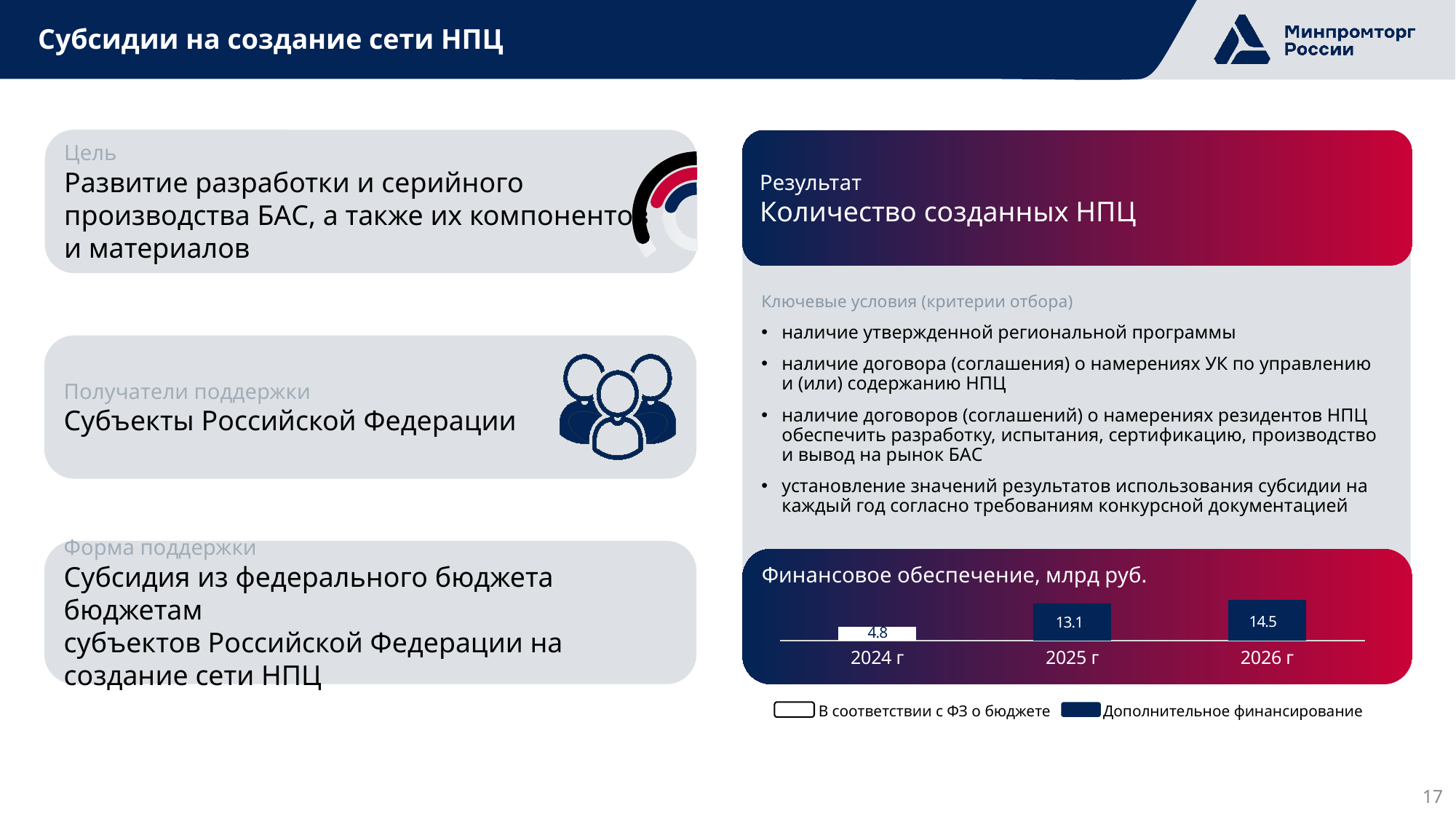
Which year has the lowest value in the chart 'Финансовое обеспечение, млрд руб.'? 2024 г What is the value shown for 2026 г in the chart 'Финансовое обеспечение, млрд руб.'? 14.5 What is the value shown for 2024 г in the chart 'Финансовое обеспечение, млрд руб.'? 4.8 In the chart 'Финансовое обеспечение, млрд руб.', what is the difference between the values for 2026 г and 2025 г? 1.4 How many entries does the legend of the chart 'Финансовое обеспечение, млрд руб.' list? 2 What is the value shown for 2025 г in the chart 'Финансовое обеспечение, млрд руб.'? 13.1 In the chart 'Финансовое обеспечение, млрд руб.', which is larger: the value for 2024 г or the value for 2025 г? 2025 г In the chart 'Финансовое обеспечение, млрд руб.', what is the difference between the values for 2025 г and 2024 г? 8.3 What kind of chart is 'Финансовое обеспечение, млрд руб.'? Bar chart Do the values in the chart 'Финансовое обеспечение, млрд руб.' rise or fall from 2024 г to 2026 г? Rise How many years are shown in the chart 'Финансовое обеспечение, млрд руб.'? 3 Which year has the highest value in the chart 'Финансовое обеспечение, млрд руб.'? 2026 г